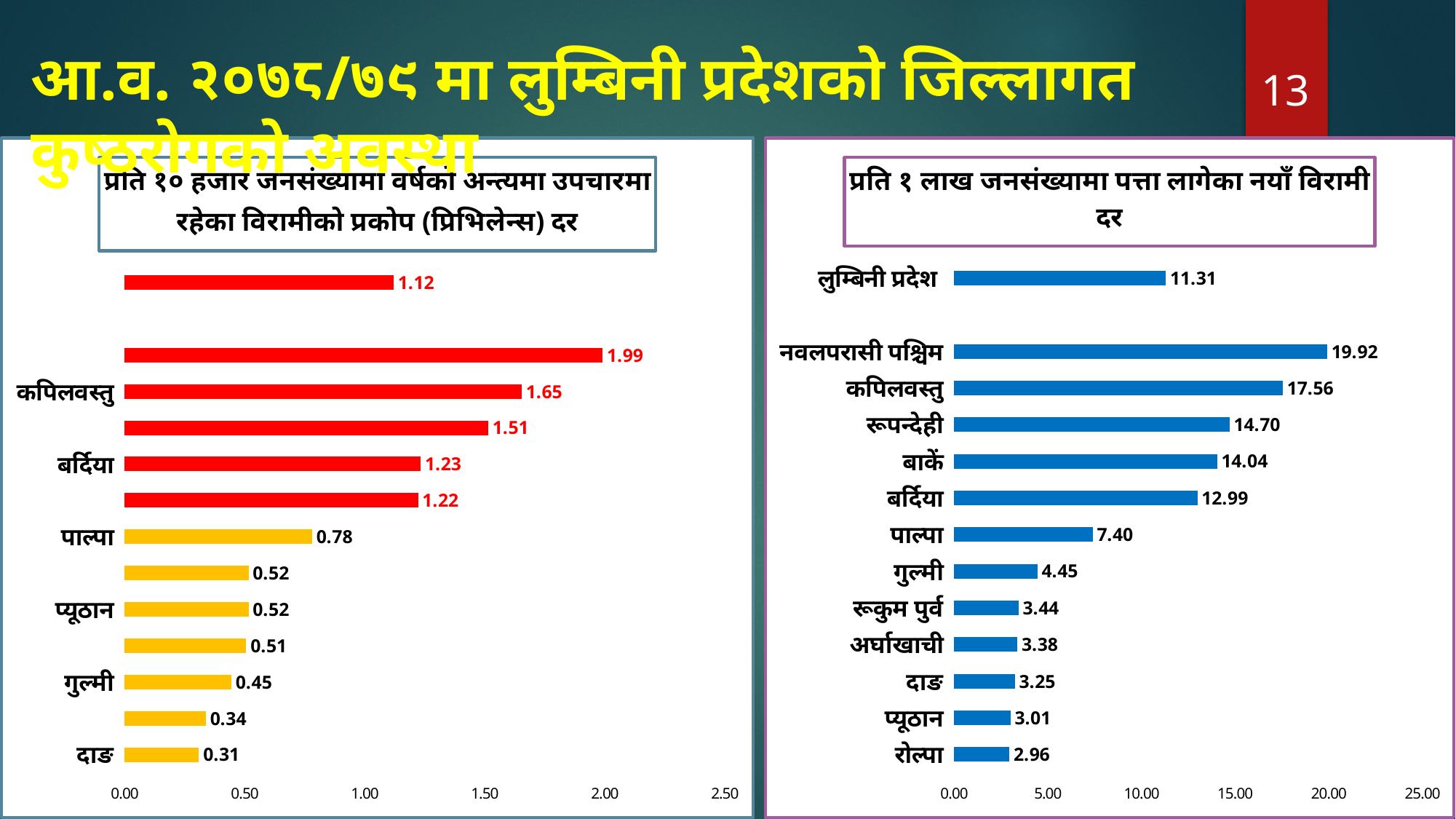
How many bars are plotted in the right chart? 13 In the right chart, which district has the lowest value? रोल्पा In the right chart, what is the difference between the values for कपिलवस्तु and बर्दिया? 4.57 In the right chart, is the value for पाल्पा greater or less than 5.00? greater In the left chart, what is the largest value shown on any bar? 1.99 In the right chart, what is the value for लुम्बिनी प्रदेश? 11.31 In the right chart, what is the value for रूपन्देही? 14.70 In the left chart, what is the difference between the values for कपिलवस्तु and बर्दिया? 0.42 In the left chart, what is the value for कपिलवस्तु? 1.65 What kind of chart is the right chart? bar chart In the left chart, which is larger, the value for पाल्पा or the value for गुल्मी? पाल्पा In the right chart, which district has the highest value? नवलपरासी पश्चिम